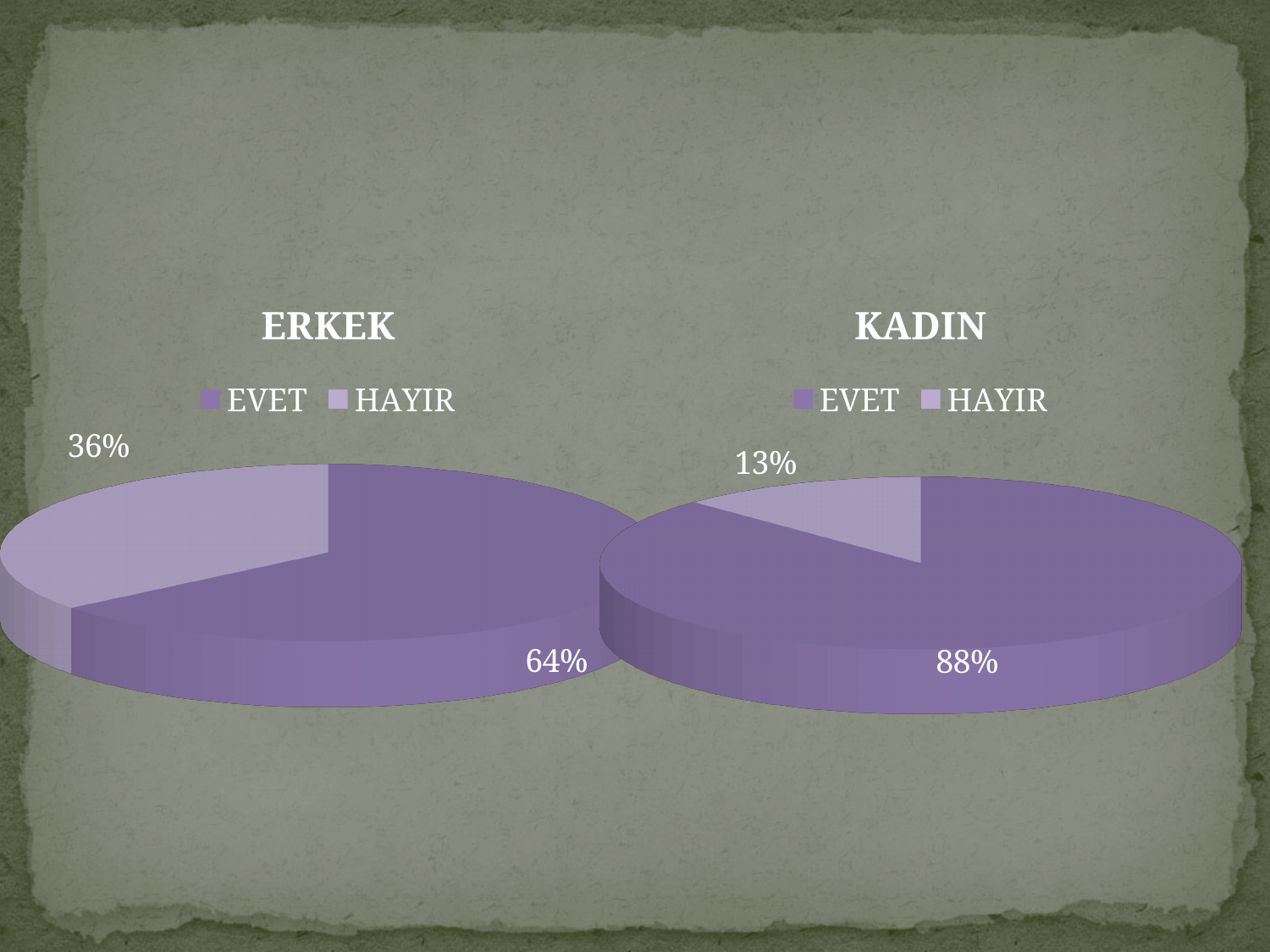
What are the two legend entries in the KADIN chart? EVET and HAYIR In the KADIN chart, what share of the pie is EVET? 88% How many slices does the KADIN chart have? 2 What kind of chart is the ERKEK chart? Pie chart In the ERKEK chart, what is the difference between the EVET and HAYIR shares? 28% In the ERKEK chart, what share of the pie is EVET? 64% In the KADIN chart, what is the difference between the EVET and HAYIR shares? 75% In the KADIN chart, which slice is the smallest? HAYIR Which chart has the larger EVET share, ERKEK or KADIN? KADIN In the ERKEK chart, what share of the pie is HAYIR? 36% In the KADIN chart, what share of the pie is HAYIR? 13% In the ERKEK chart, which slice is the largest? EVET